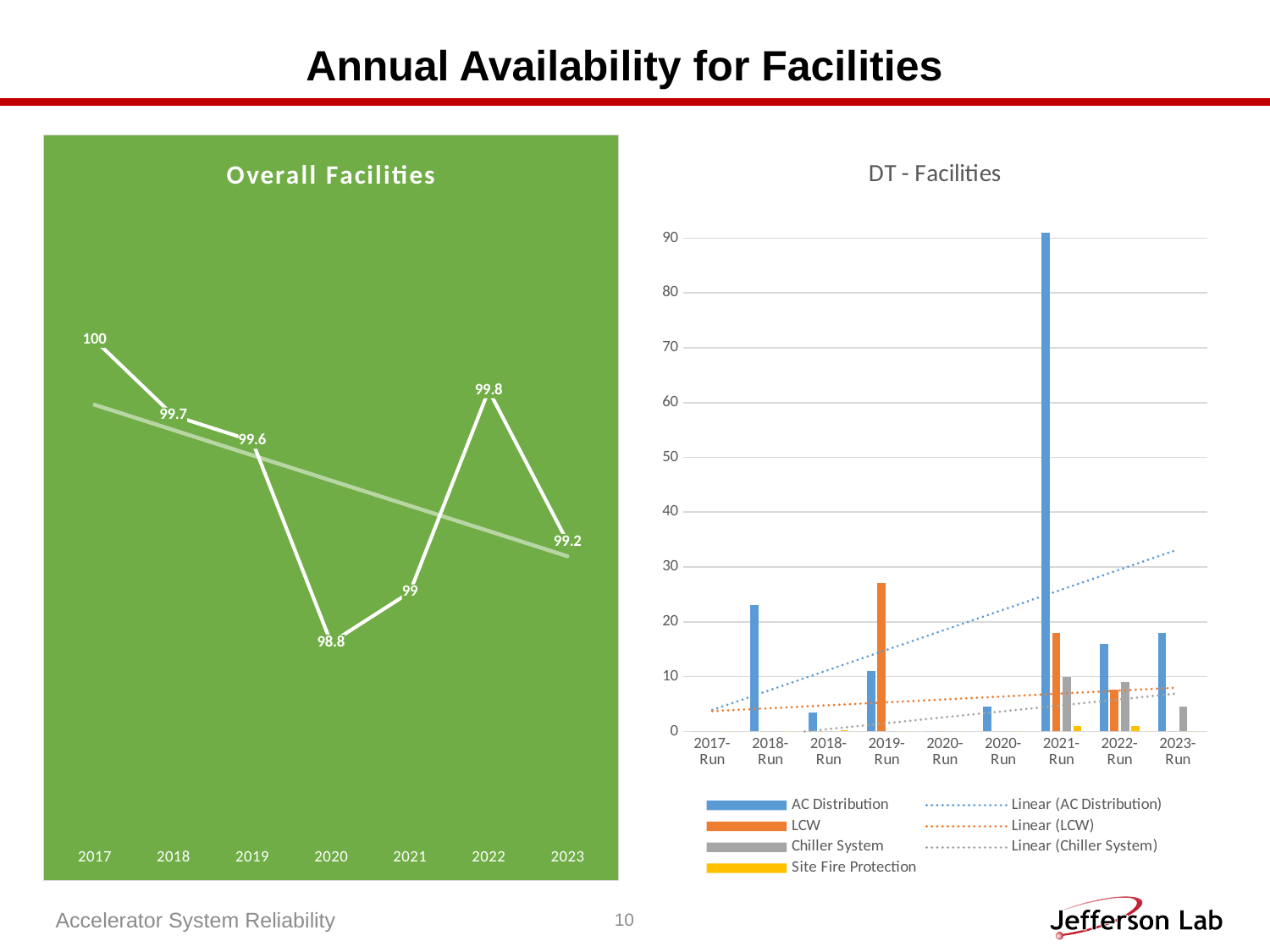
In the DT - Facilities chart, is the AC Distribution value for 2021-Run greater or less than 80? greater In the Overall Facilities chart, what is the value for 2022? 99.8 How many entries does the legend of the DT - Facilities chart list? 7 How many years are plotted in the Overall Facilities chart? 7 What kind of chart is the Overall Facilities chart? Line chart In the Overall Facilities chart, which year has the lowest value? 2020 In the Overall Facilities chart, what is the value for 2020? 98.8 In the Overall Facilities chart, which year has the larger value, 2021 or 2023? 2023 In the Overall Facilities chart, does the value rise or fall from 2019 to 2020? Fall In the Overall Facilities chart, what is the difference between the values for 2017 and 2020? 1.2 In the DT - Facilities chart, is the LCW value for 2019-Run greater or less than 20? greater In the Overall Facilities chart, which year has the highest value? 2017